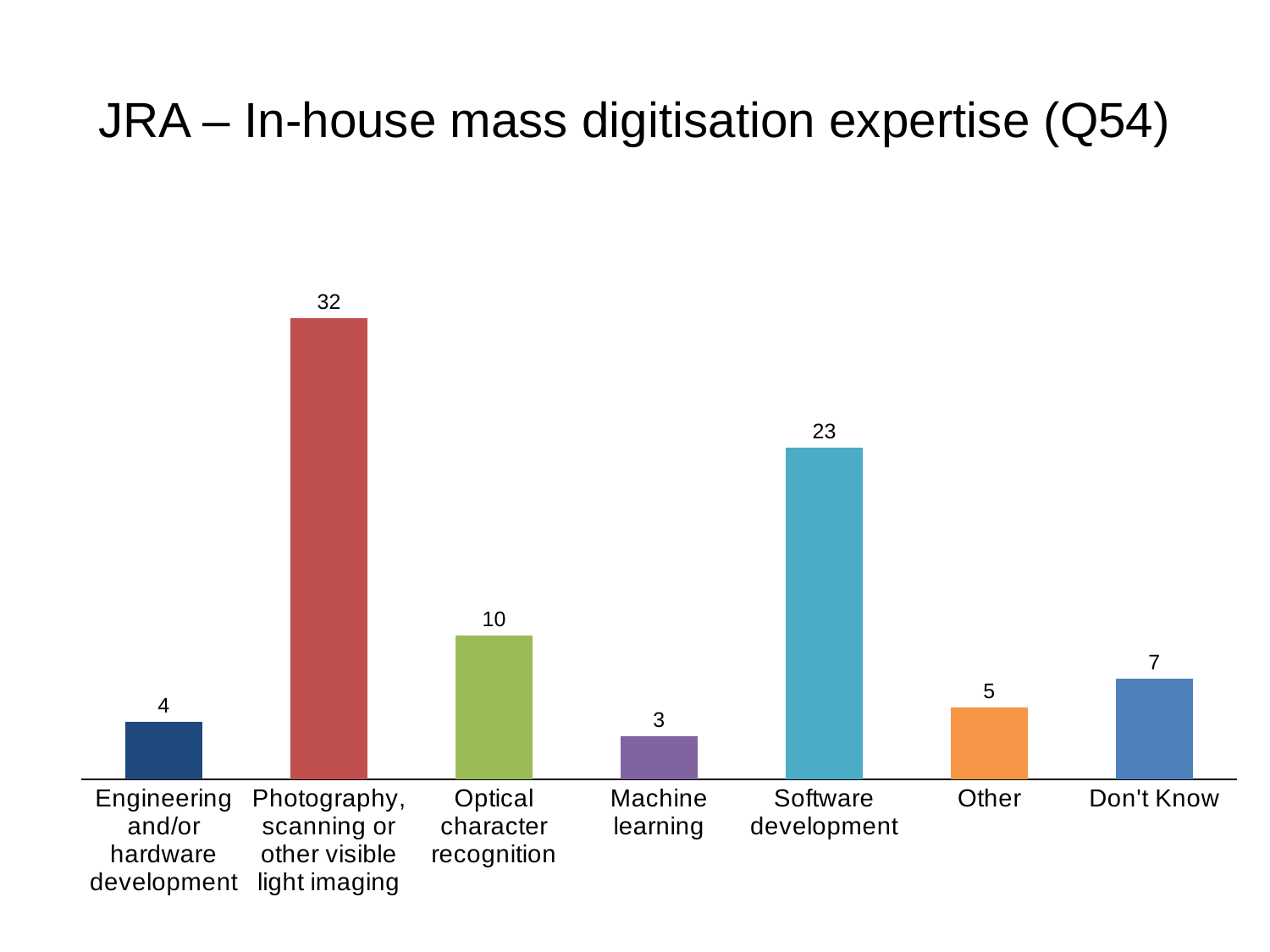
Which category has the highest value? Photography, scanning or other visible light imaging Which category has the lowest value? Machine learning What is the title of the chart on the slide? JRA – In-house mass digitisation expertise (Q54) How many categories are shown on the chart? 7 What kind of chart is shown on the slide? Bar chart What is the value for Machine learning? 3 What is the difference between the values for Optical character recognition and Other? 5 What is the value for Don't Know? 7 Which is larger, the value for Engineering and/or hardware development or the value for Don't Know? Don't Know What is the difference between the values for Photography, scanning or other visible light imaging and Software development? 9 What is the value for Software development? 23 Which is larger, the value for Optical character recognition or the value for Other? Optical character recognition